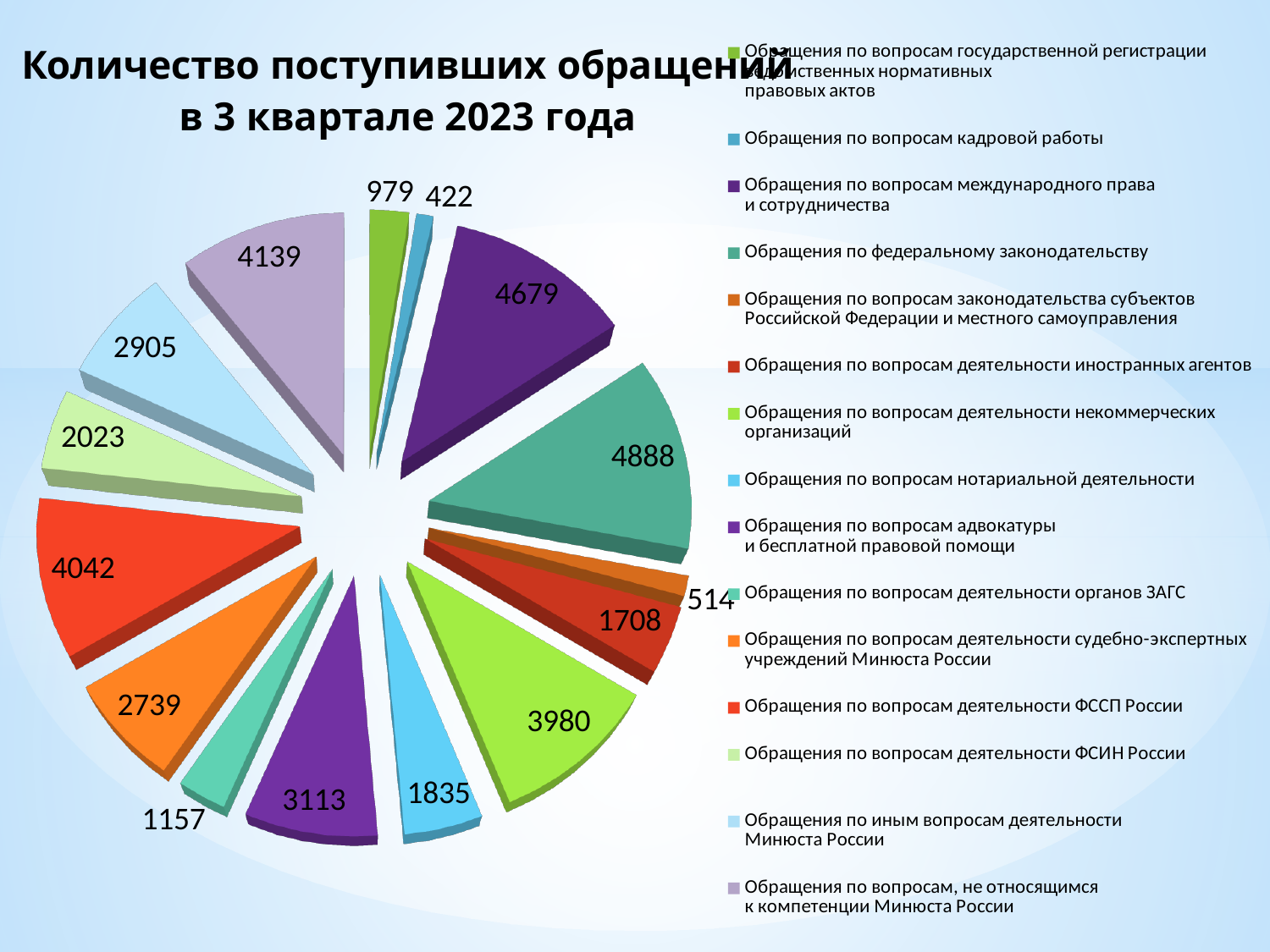
What is the value for «Обращения по вопросам кадровой работы»? 422 What is the title of the chart? Количество поступивших обращений в 3 квартале 2023 года Which category has the smallest value? Обращения по вопросам кадровой работы What is the value for «Обращения по вопросам деятельности ФССП России»? 4042 Which is larger: the value for «Обращения по вопросам деятельности ФСИН России» or for «Обращения по иным вопросам деятельности Минюста России»? Обращения по иным вопросам деятельности Минюста России What is the difference between the values for «Обращения по вопросам адвокатуры и бесплатной правовой помощи» and «Обращения по вопросам деятельности органов ЗАГС»? 1956 What is the value for «Обращения по вопросам нотариальной деятельности»? 1835 What is the difference between the values for «Обращения по федеральному законодательству» and «Обращения по вопросам международного права и сотрудничества»? 209 Which category has the largest value? Обращения по федеральному законодательству What type of chart is shown on the slide? Pie chart How many categories does the legend list? 15 What is the value for «Обращения по федеральному законодательству»? 4888